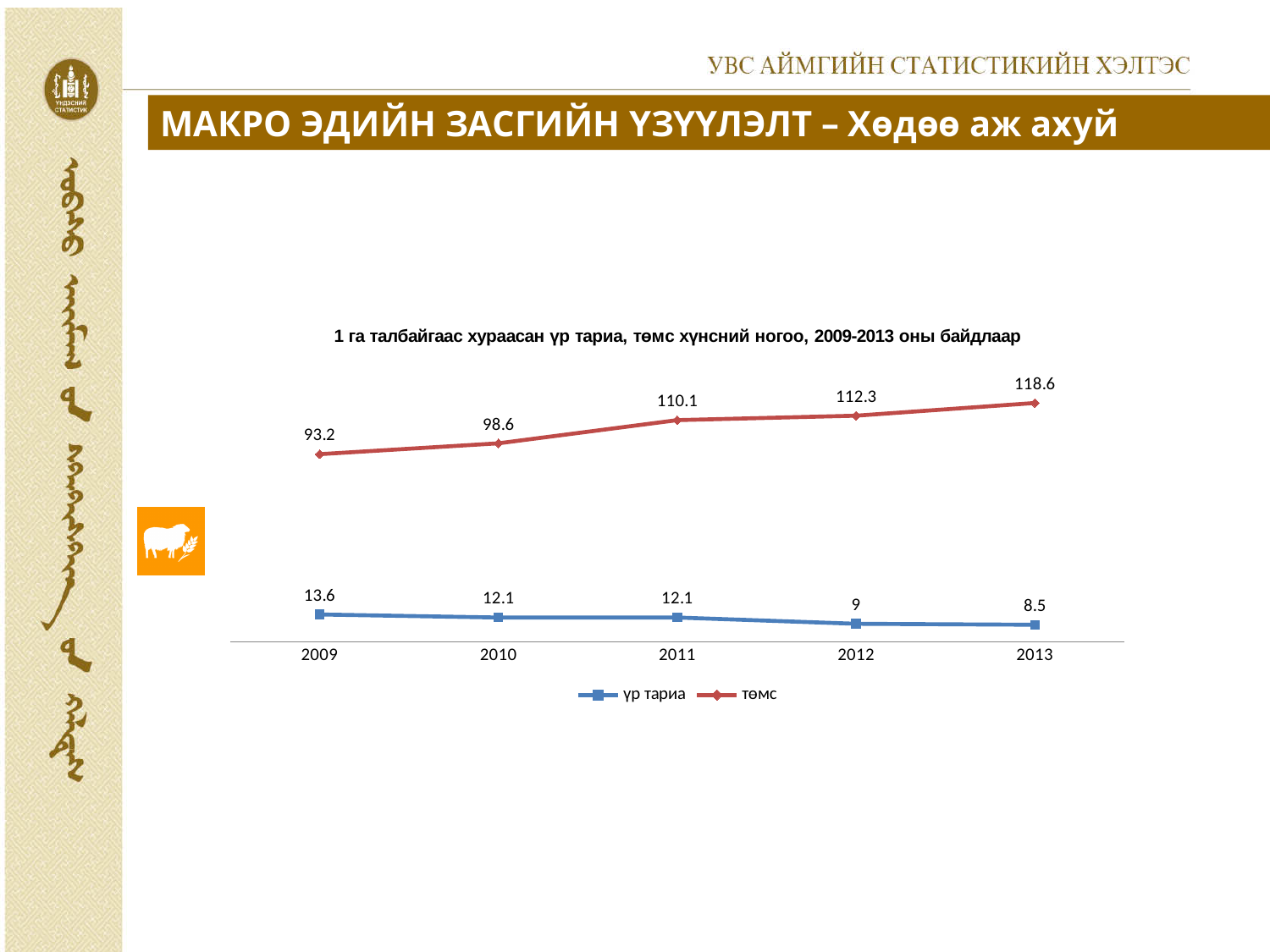
What is the value for төмс in 2013? 118.6 Which is larger in 2010: the value for төмс or the value for үр тариа? төмс How many series does the legend list? 2 What is the difference between the төмс values in 2013 and 2009? 25.4 What is the value for үр тариа in 2009? 13.6 What is the value for үр тариа in 2012? 9 What is the difference between the үр тариа values in 2009 and 2013? 5.1 In which year is the value for төмс highest? 2013 What is the value for төмс in 2011? 110.1 How many years are shown on the x axis? 5 What kind of chart is shown on the slide? line chart In which year is the value for үр тариа lowest? 2013